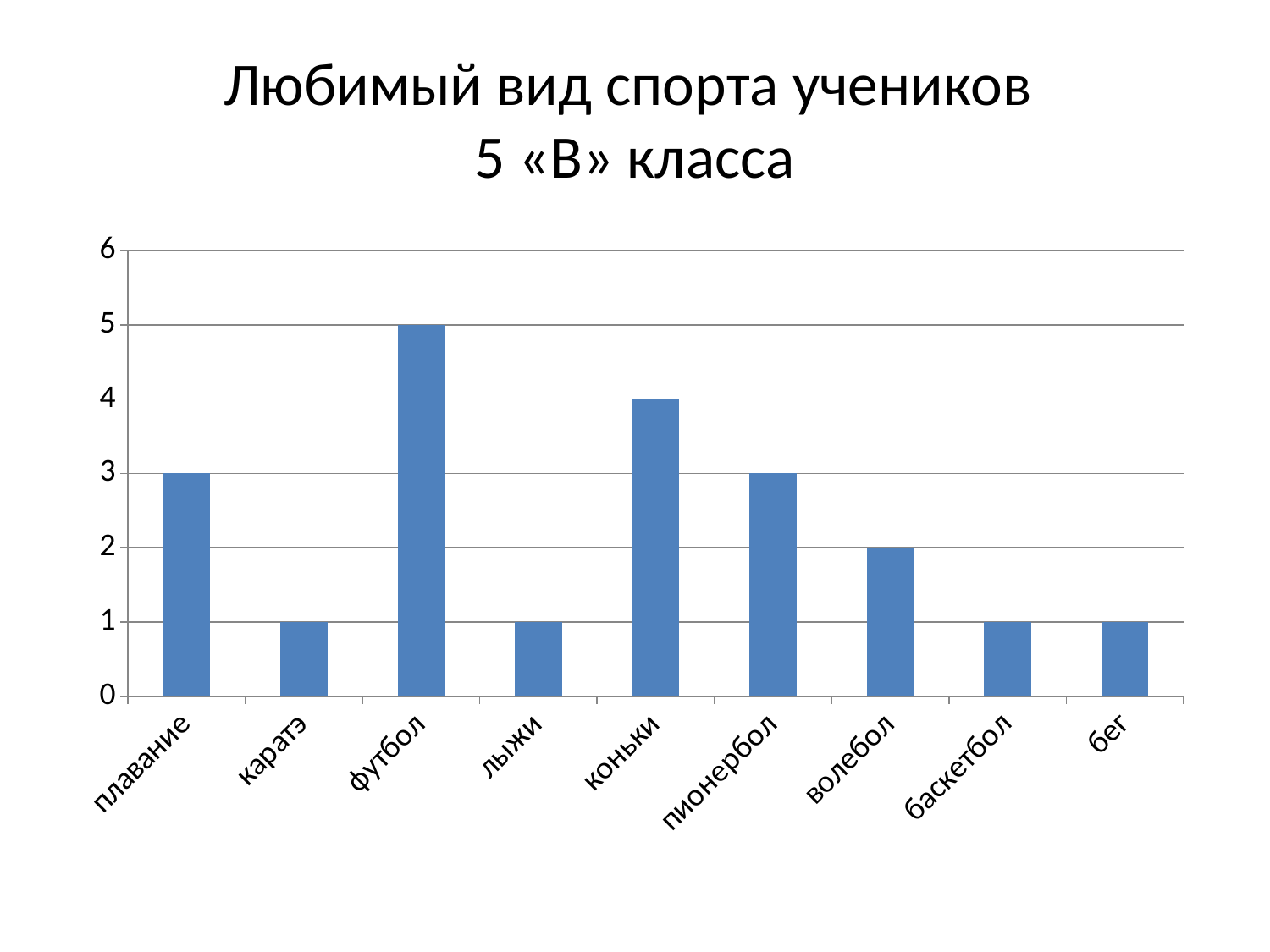
What is the title of the chart on the slide? Любимый вид спорта учеников 5 «В» класса What is the value for плавание? 3 How many categories are shown on the x axis? 9 What is the value for футбол? 5 What is the difference between the values for пионербол and каратэ? 2 What is the value for волебол? 2 Which category has the highest value? футбол Which is larger, the value for коньки or the value for волебол? коньки What is the difference between the values for футбол and коньки? 1 Is the value for футбол greater or less than 4? greater What is the value for коньки? 4 What kind of chart is shown on the slide? bar chart